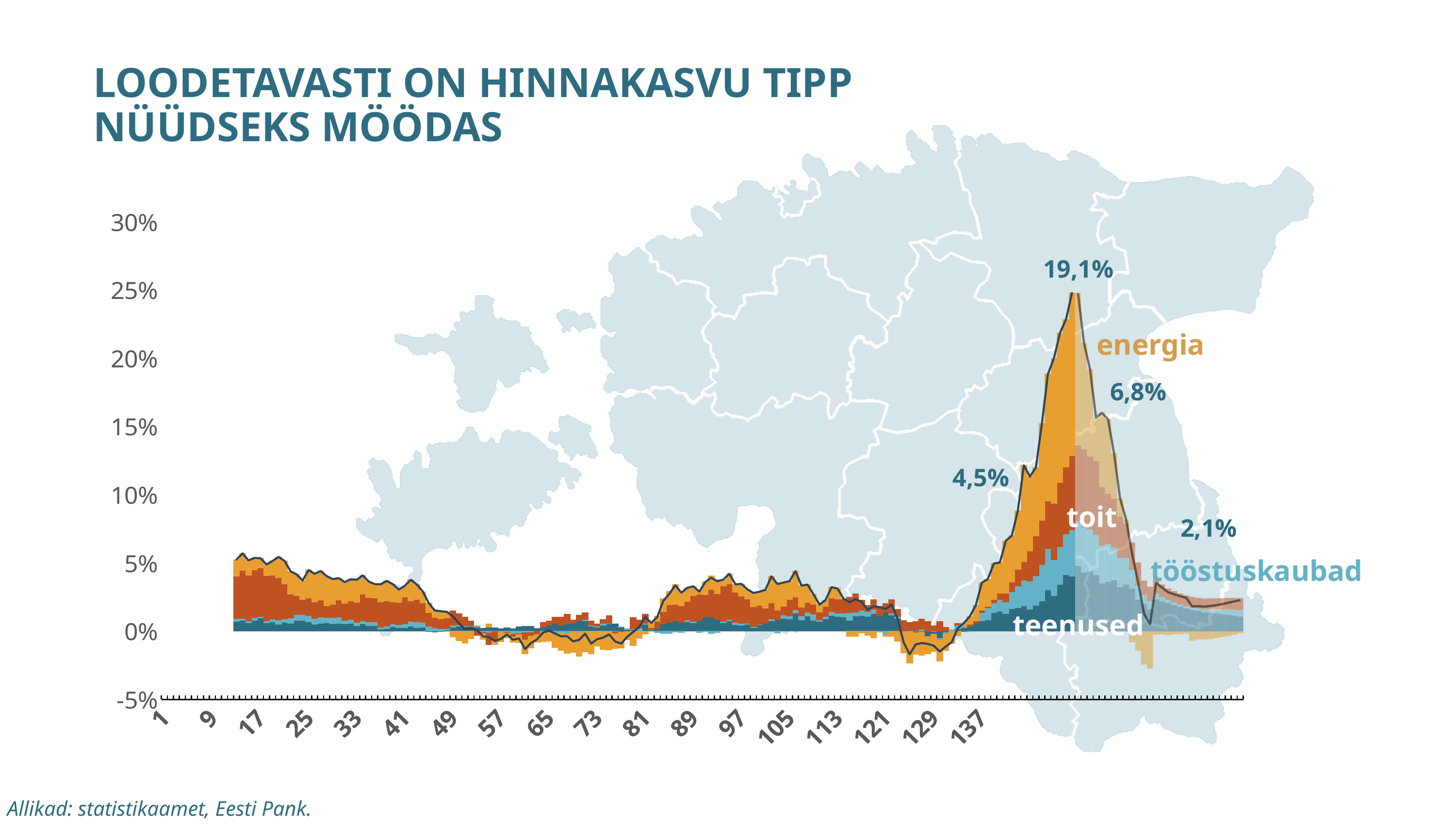
What kind of chart is shown on the slide? Bar chart (stacked bars with a line) Which labelled value is larger, 19,1% or 4,5%? 19,1% What is the lowest value labelled on the chart? 2,1% What is the title of the chart on the slide? LOODETAVASTI ON HINNAKASVU TIPP NÜÜDSEKS MÖÖDAS What is the difference between the labelled values 6,8% and 2,1%? 4,7% What is the highest value labelled on the chart? 19,1% How many components are labelled in the chart (energia, toit, tööstuskaubad, teenused)? 4 What is the highest tick shown on the vertical axis? 30% Is the peak of the line greater or less than 15%? greater What is the difference between the labelled peak value 19,1% and the later labelled value 6,8%? 12,3% Does the line rise or fall between the labelled points 19,1% and 2,1%? fall Is the value at the far right end of the line greater or less than 5%? less